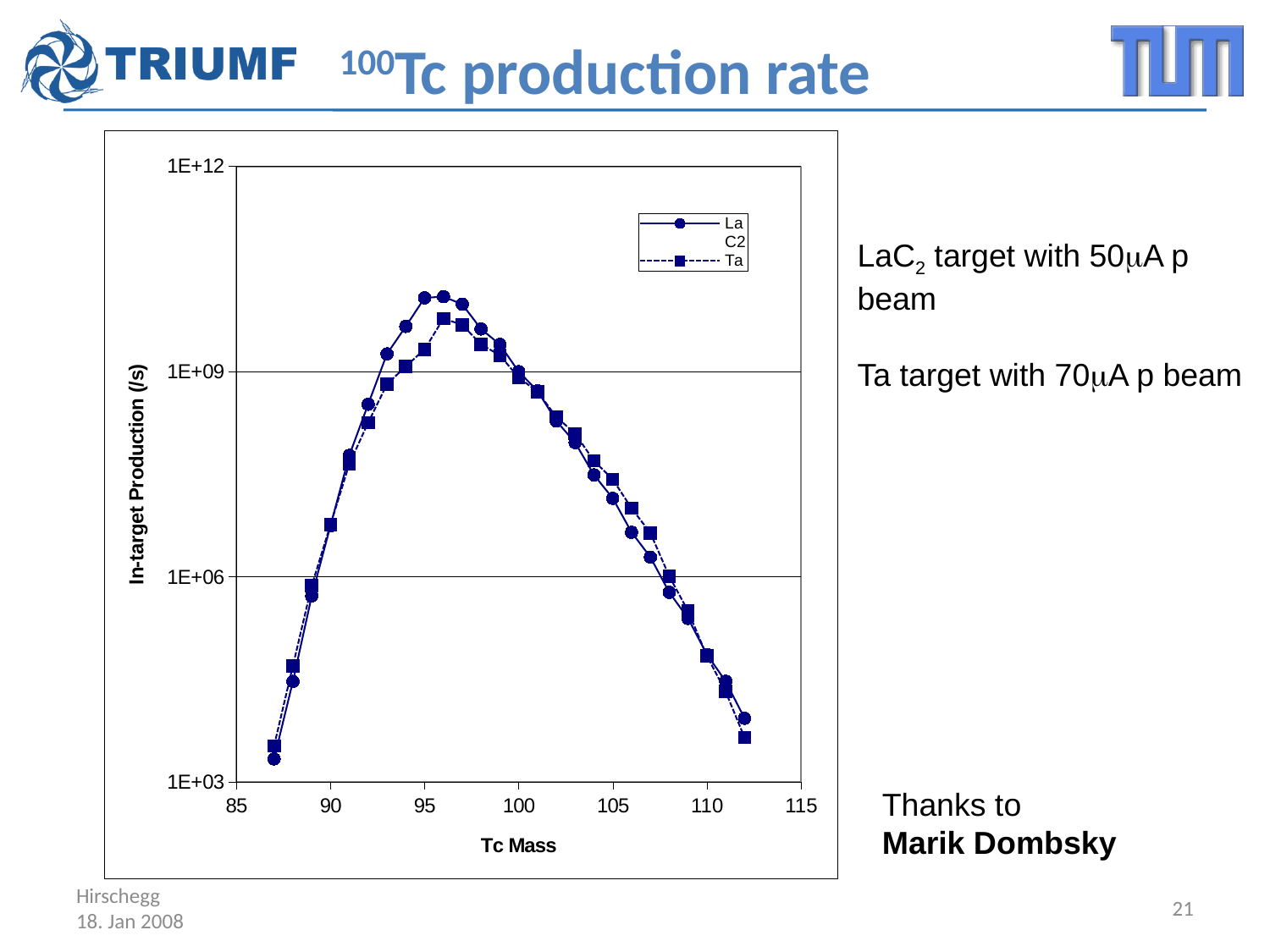
At which Tc mass is the La C2 series at its lowest in-target production? 87 At Tc mass 95, which series has the higher in-target production, La C2 or Ta? La C2 How many series does the chart legend list? 2 How does the in-target production of the La C2 series change as Tc mass increases from 87 to 96? it rises What is the title of the x axis of the chart? Tc Mass At Tc mass 105, which series has the higher in-target production, La C2 or Ta? Ta Is the La C2 in-target production at Tc mass 112 greater or less than 1E+06? less What kind of chart is shown on the slide? line chart At which Tc mass does the Ta series reach its highest in-target production? 96 What are the two series named in the chart legend? La C2 and Ta Is the La C2 in-target production at Tc mass 96 greater or less than 1E+09? greater Is the Ta in-target production at Tc mass 105 greater or less than 1E+09? less